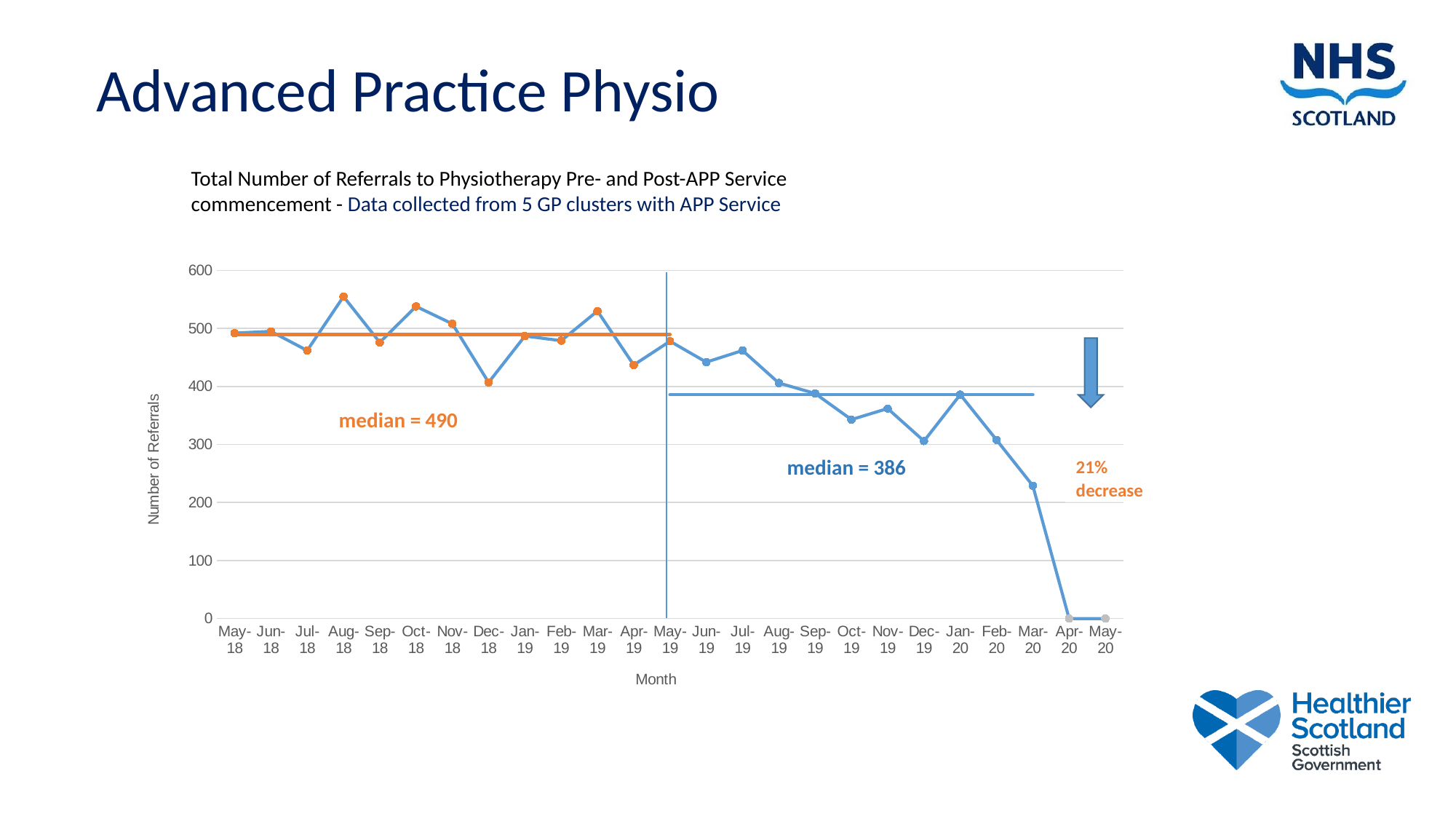
What is the median number of referrals shown for the period after the APP service commenced (blue line)? 386 Is the value for Mar-20 greater or less than 300? less What is the difference between the pre-APP median (490) and the post-APP median (386)? 104 Which month has more referrals, Jan-20 or Mar-20? Jan-20 Which month has the highest number of referrals? Aug-18 What is the median number of referrals shown for the period before the APP service commenced (orange line)? 490 What percentage decrease in referrals is annotated on the chart? 21% Is the value for Aug-18 greater or less than 500? greater How many months are plotted along the x axis? 25 What kind of chart is shown on the slide? line chart What is the label on the y axis of the chart? Number of Referrals What is the number of referrals plotted for Apr-20? 0